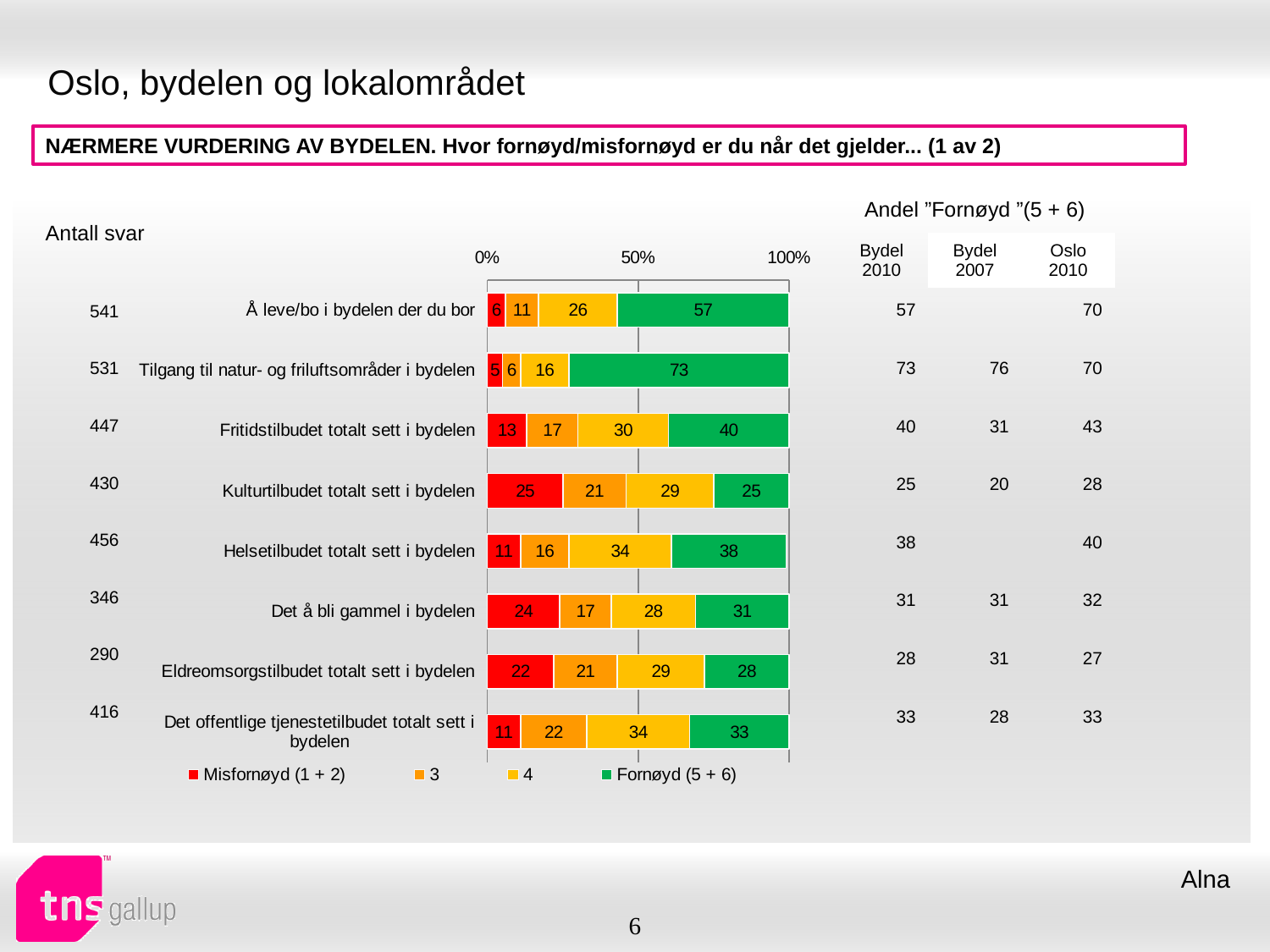
How many series does the legend list? 4 What is the value of "Fornøyd (5 + 6)" for "Tilgang til natur- og friluftsområder i bydelen"? 73 What is the difference between the "Fornøyd (5 + 6)" values for "Å leve/bo i bydelen der du bor" and "Fritidstilbudet totalt sett i bydelen"? 17 What is the value of series "4" for "Helsetilbudet totalt sett i bydelen"? 34 How many categories are shown in the chart? 8 What colour represents "Fornøyd (5 + 6)" in the chart? Green Which category has the lowest "Fornøyd (5 + 6)" value? Kulturtilbudet totalt sett i bydelen What kind of chart is shown on the slide? Stacked bar chart What is the total of the stacked bar for "Å leve/bo i bydelen der du bor"? 100 Which category has the highest "Fornøyd (5 + 6)" value? Tilgang til natur- og friluftsområder i bydelen Which is larger: the "Misfornøyd (1 + 2)" value for "Det å bli gammel i bydelen" or for "Eldreomsorgstilbudet totalt sett i bydelen"? Det å bli gammel i bydelen What is the value of "Misfornøyd (1 + 2)" for "Kulturtilbudet totalt sett i bydelen"? 25